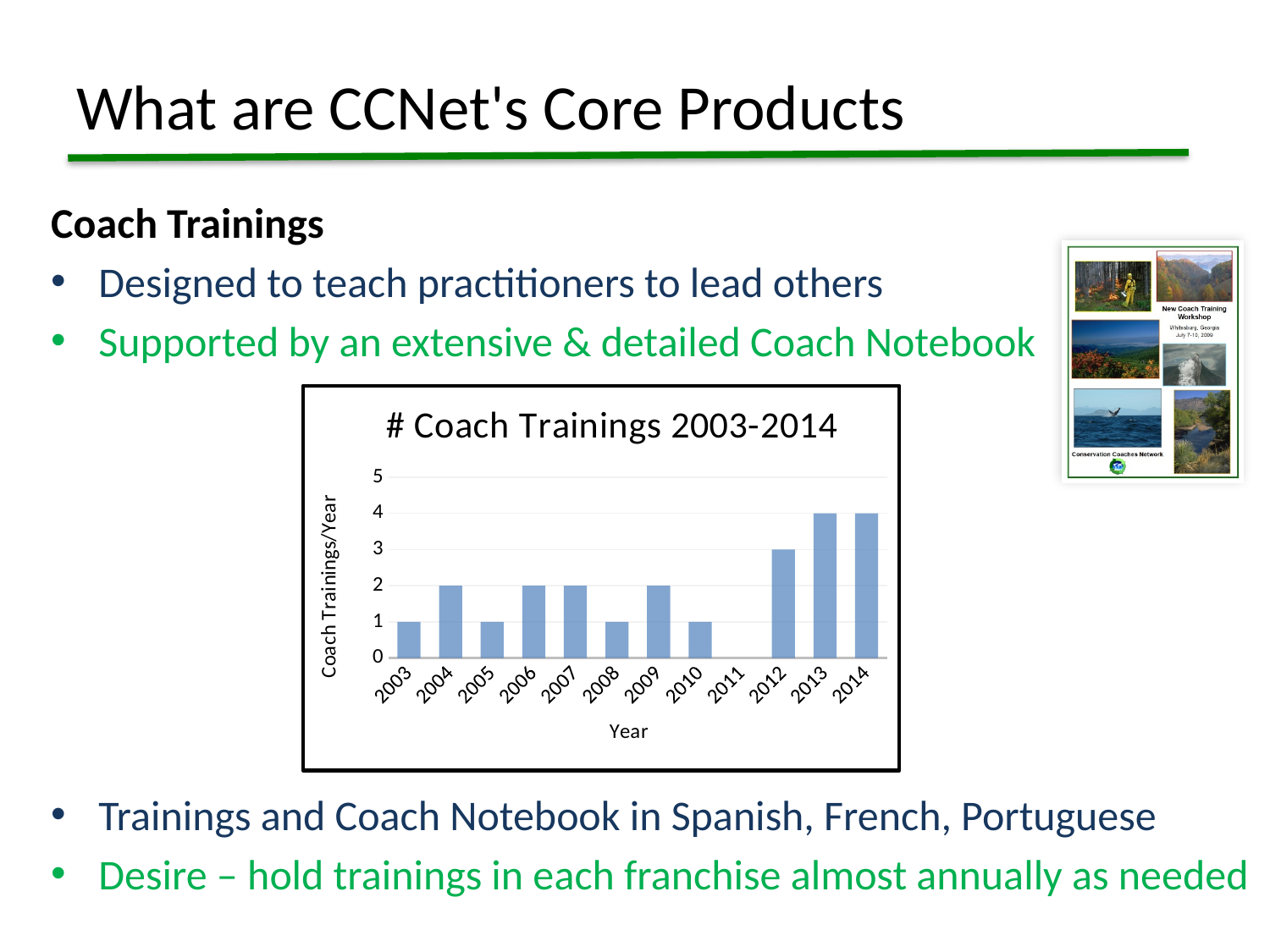
How many coach trainings were held in 2003? 1 What is the difference between the number of coach trainings in 2013 and in 2012? 1 Do the values rise or fall from 2011 to 2014? rise How many years are shown on the x axis of the chart? 12 What is the label on the vertical axis of the chart? Coach Trainings/Year What kind of chart is shown on the slide? bar chart How many coach trainings were held in 2011? 0 Which year had more coach trainings, 2012 or 2009? 2012 What is the chart's title? # Coach Trainings 2003-2014 How many coach trainings were held in 2012? 3 How many coach trainings were held in 2013? 4 Which year has the lowest number of coach trainings? 2011